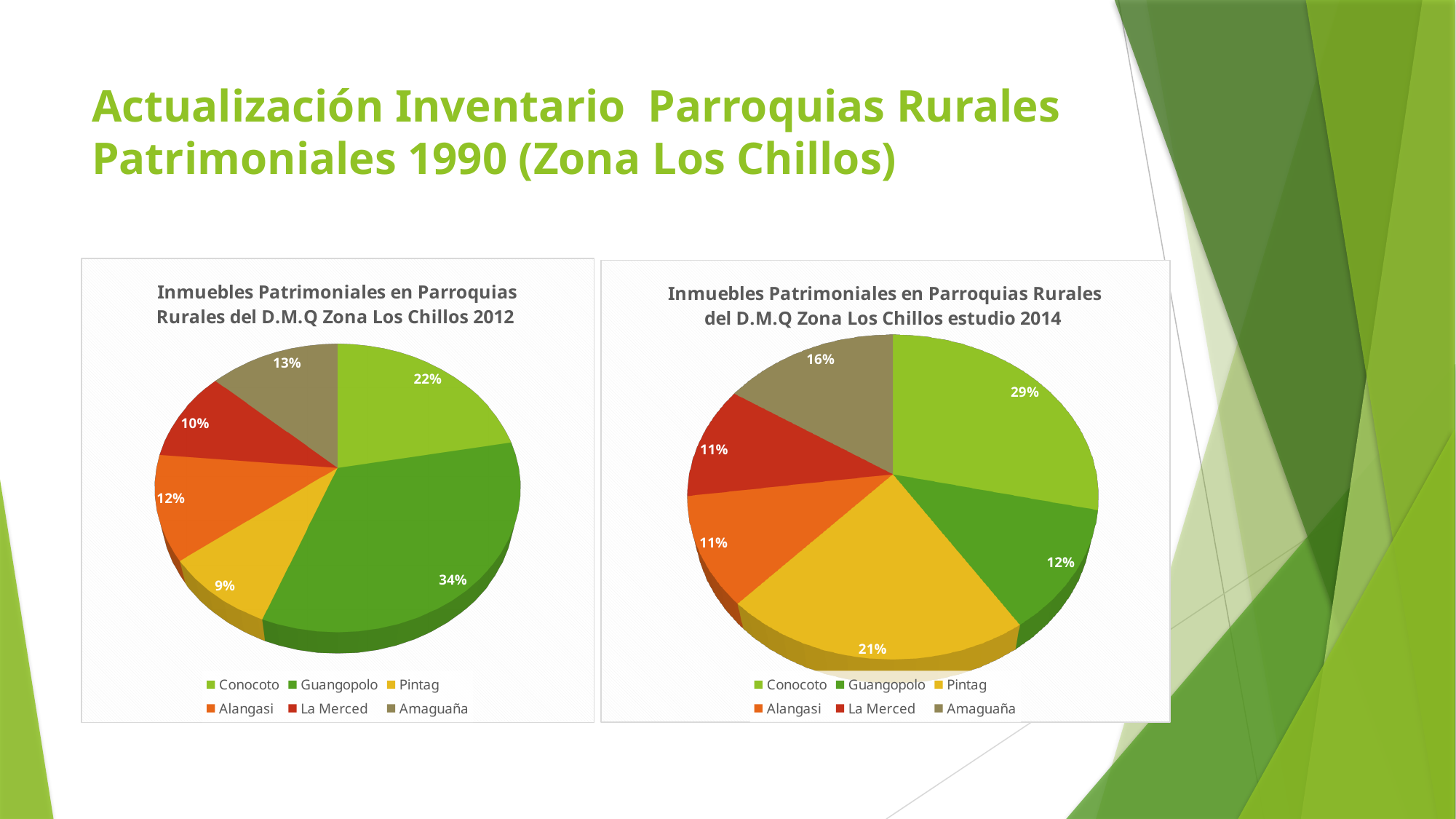
What type of chart is the 2012 chart on the left? Pie chart In the 2012 chart on the left, what share does Amaguaña have? 13% In the 2012 chart on the left, what share does Guangopolo have? 34% In the 2014 chart on the right, what share does Pintag have? 21% How many entries does the legend of the 2012 chart on the left list? 6 In the 2012 chart on the left, which parish has the smallest slice? Pintag How many slices does the 2014 chart on the right have? 6 In the 2012 chart on the left, which parish has the largest slice? Guangopolo In the 2012 chart on the left, which is larger, the Alangasi slice or the La Merced slice? Alangasi In the 2014 chart on the right, what share does Guangopolo have? 12% In the 2014 chart on the right, which parish has the largest slice? Conocoto In the 2014 chart on the right, what is the difference between the Conocoto share and the Amaguaña share? 13%